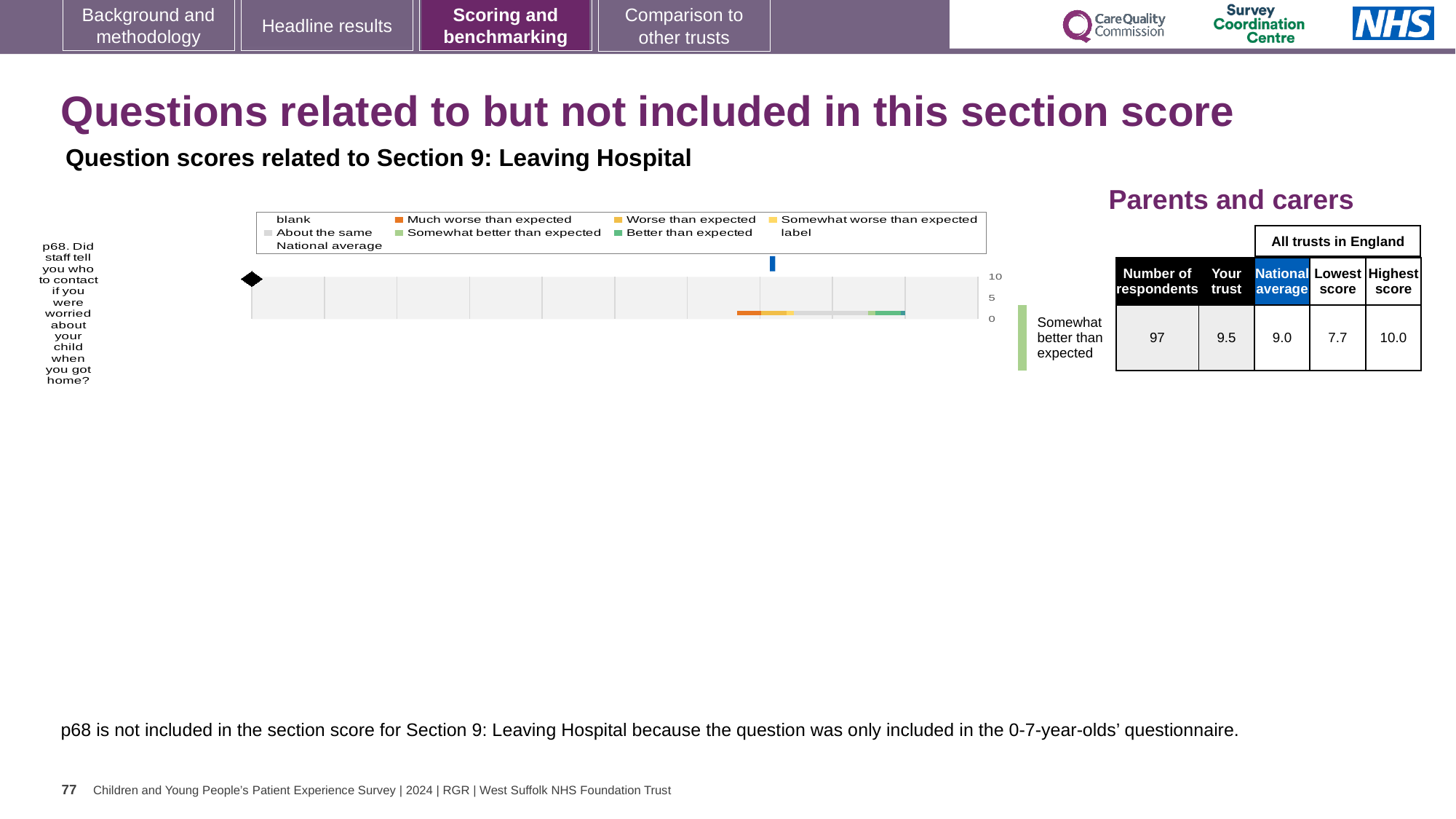
How many respondents answered question p68? 97 How many questions are plotted on the chart? 1 What is the national average score for p68? 9.0 What is the difference between the highest and lowest scores for p68 across all trusts in England? 2.3 By how much does the 'Your trust' score for p68 exceed the national average? 0.5 What is the 'Your trust' score for p68 (Did staff tell you who to contact if you were worried about your child when you got home?)? 9.5 What is the lowest score among all trusts in England for p68? 7.7 Which is higher for p68: the 'Your trust' score or the national average? Your trust What kind of chart is shown for question p68? bar chart Is the 'Your trust' score for p68 greater or less than 5 on the chart's axis? greater What benchmarking category is the trust's result for p68 labelled as? Somewhat better than expected What is the highest score among all trusts in England for p68? 10.0